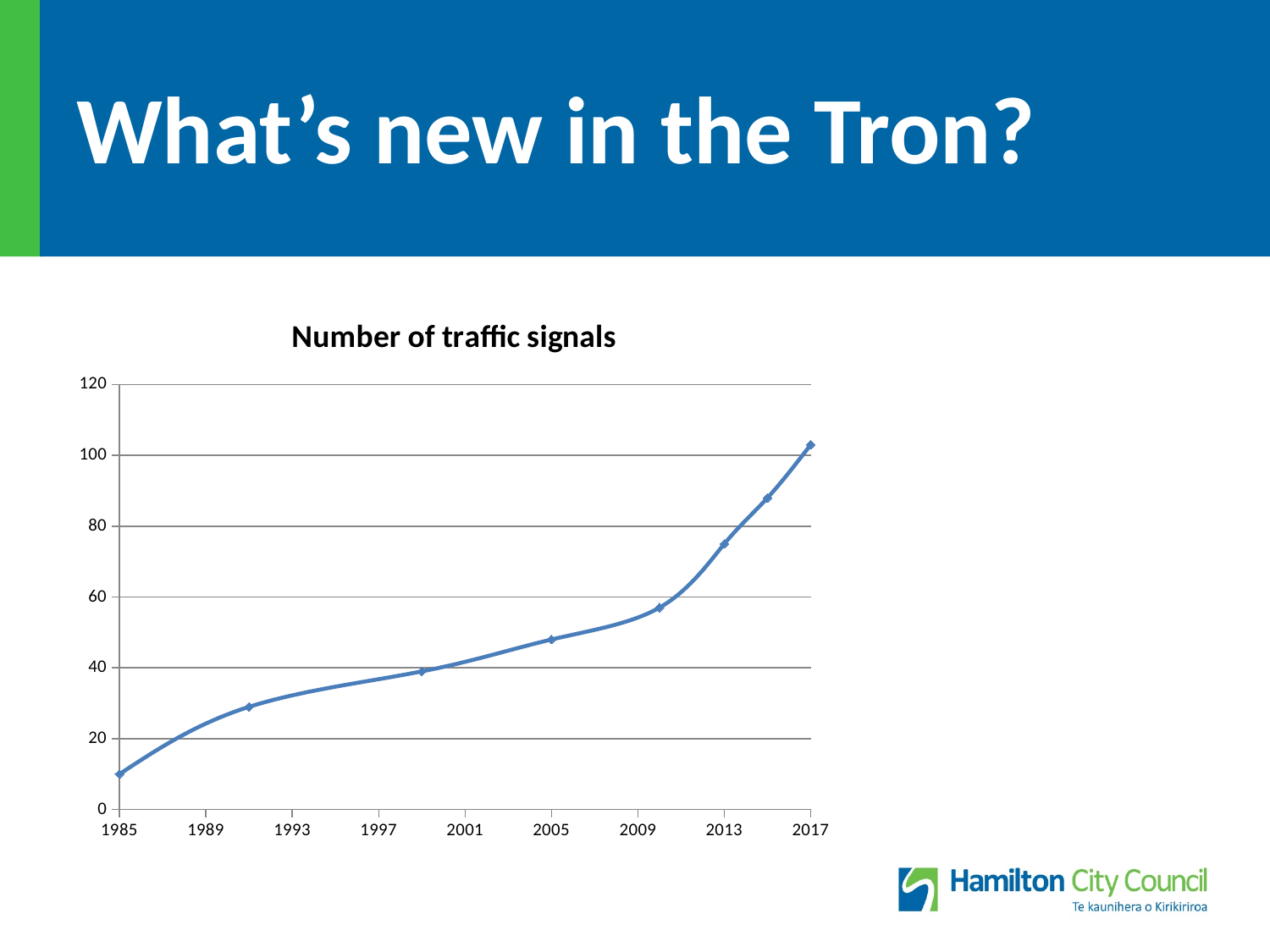
Is the value for 2005 greater or less than 40? greater Which is larger, the value for 2013 or the value for 2005? 2013 Is the value for 1985 greater or less than 20? less Is the value for 2013 greater or less than 60? greater What is the title of the chart? Number of traffic signals How many data points are plotted on the line? 8 What is the highest value shown on the vertical axis? 120 What kind of chart is shown on the slide? line chart Do the values in the chart rise or fall from 1985 to 2017? rise In which year is the number of traffic signals lowest? 1985 In which year is the number of traffic signals highest? 2017